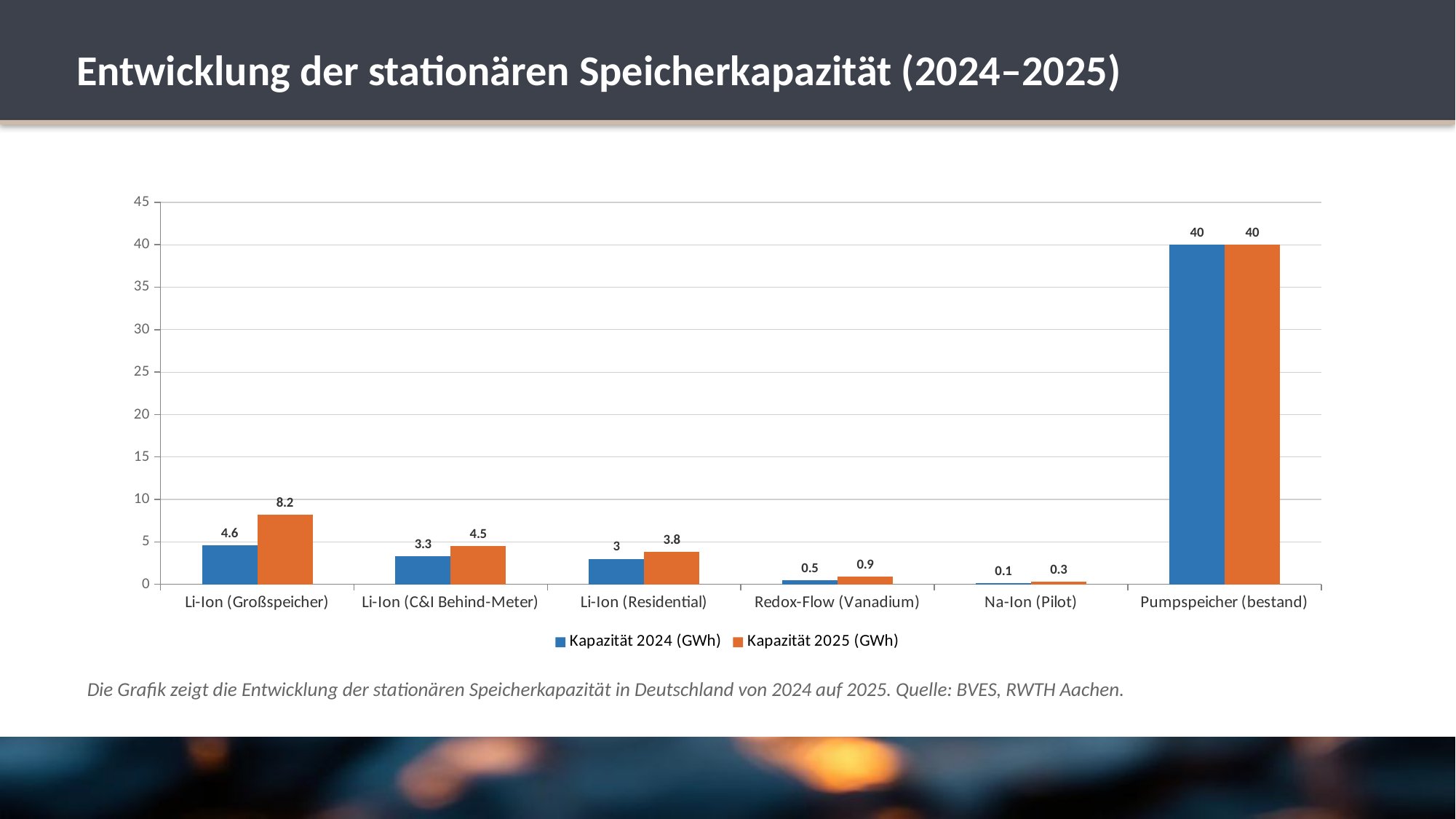
What is the Kapazität 2024 (GWh) value for Li-Ion (C&I Behind-Meter)? 3.3 What is the difference between the Kapazität 2025 values for Li-Ion (Residential) and Redox-Flow (Vanadium)? 2.9 What is the Kapazität 2024 (GWh) value for Na-Ion (Pilot)? 0.1 What is the Kapazität 2025 (GWh) value for Li-Ion (Großspeicher)? 8.2 Which is larger: the Kapazität 2025 value for Li-Ion (C&I Behind-Meter) or for Li-Ion (Residential)? Li-Ion (C&I Behind-Meter) What is the difference between the Kapazität 2025 and Kapazität 2024 values for Li-Ion (Großspeicher)? 3.6 How many series does the legend list? 2 Which category has the lowest Kapazität 2024 (GWh) value? Na-Ion (Pilot) Which colour represents the Kapazität 2025 (GWh) series? Orange How many categories are shown on the x axis? 6 Which category has the highest Kapazität 2025 (GWh) value? Pumpspeicher (bestand) What kind of chart is shown on the slide? Bar chart